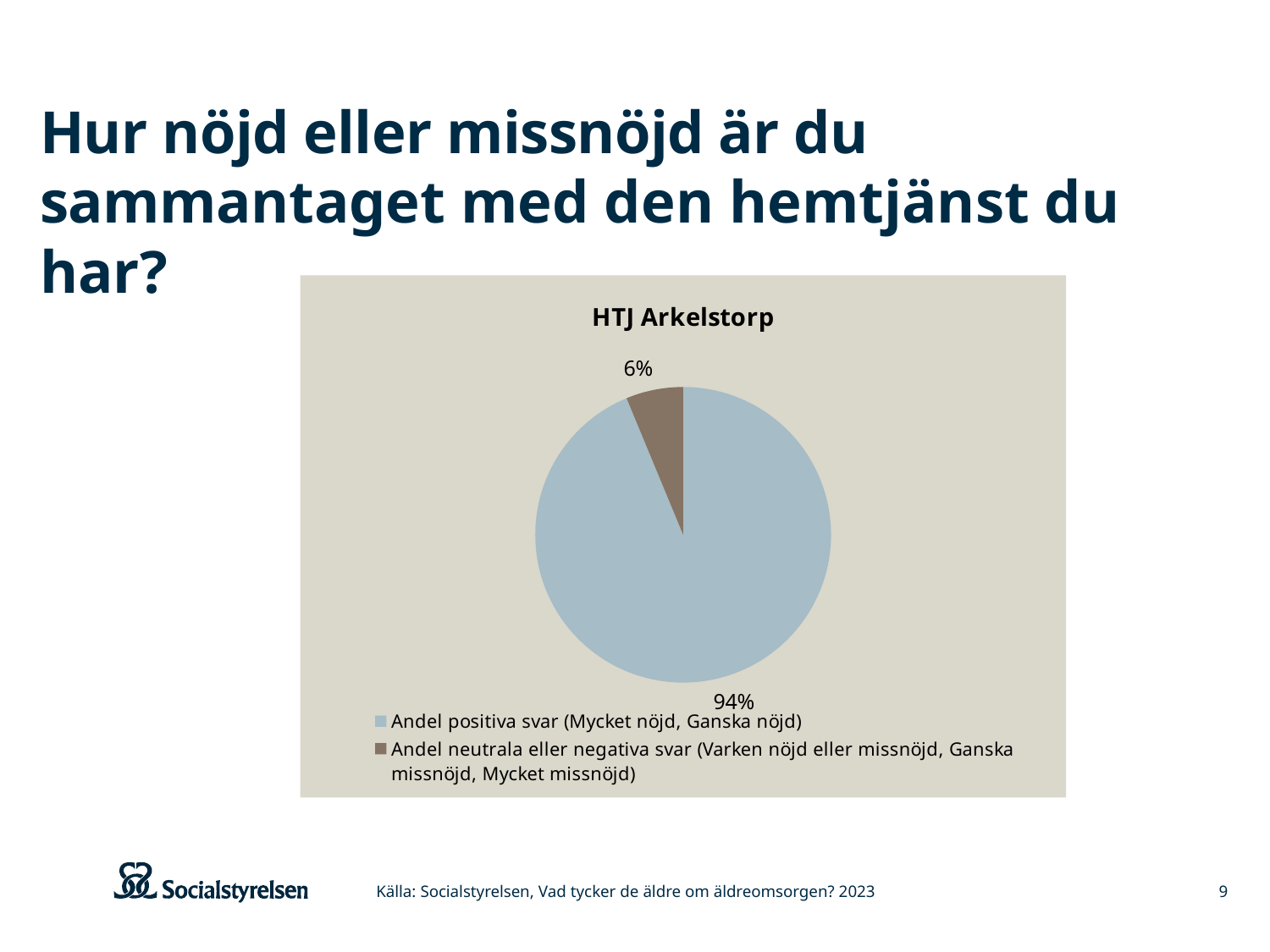
What share of the pie is 'Andel positiva svar (Mycket nöjd, Ganska nöjd)'? 94% Which is larger: the share of positive answers or the share of neutral or negative answers? Andel positiva svar (Mycket nöjd, Ganska nöjd) What is the chart's title? HTJ Arkelstorp What share of the pie is 'Andel neutrala eller negativa svar (Varken nöjd eller missnöjd, Ganska missnöjd, Mycket missnöjd)'? 6% Which slice is the largest? Andel positiva svar (Mycket nöjd, Ganska nöjd) What is the difference in percentage points between the positive slice and the neutral/negative slice? 88 Which slice is the smallest? Andel neutrala eller negativa svar (Varken nöjd eller missnöjd, Ganska missnöjd, Mycket missnöjd) What kind of chart is shown on the slide? pie chart What colour is the slice for 'Andel positiva svar (Mycket nöjd, Ganska nöjd)'? light blue How many entries does the legend list? 2 How many slices does the pie chart have? 2